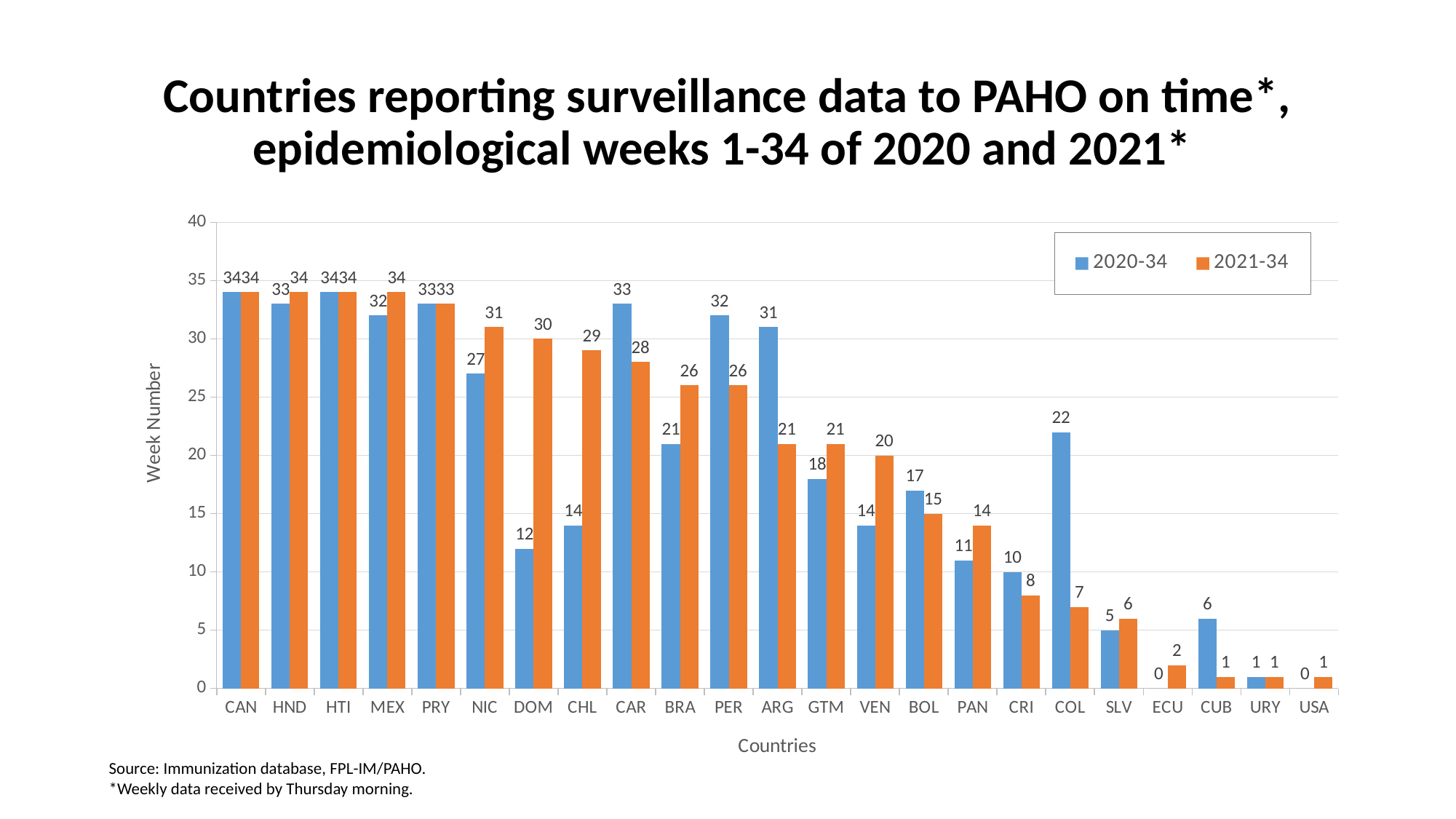
What is the 2020-34 value for NIC? 27 Is the 2020-34 value for ARG greater or less than 30? greater For CAR, which series has the larger value, 2020-34 or 2021-34? 2020-34 What is the difference between the 2020-34 and 2021-34 values for COL? 15 What is the difference between the 2021-34 and 2020-34 values for DOM? 18 What kind of chart is shown on the slide? bar chart How many series does the legend list? 2 How many countries are shown on the x axis? 23 What is the 2021-34 value for DOM? 30 What is the 2020-34 value for COL? 22 For CHL, which series has the larger value, 2020-34 or 2021-34? 2021-34 What is the 2021-34 value for VEN? 20